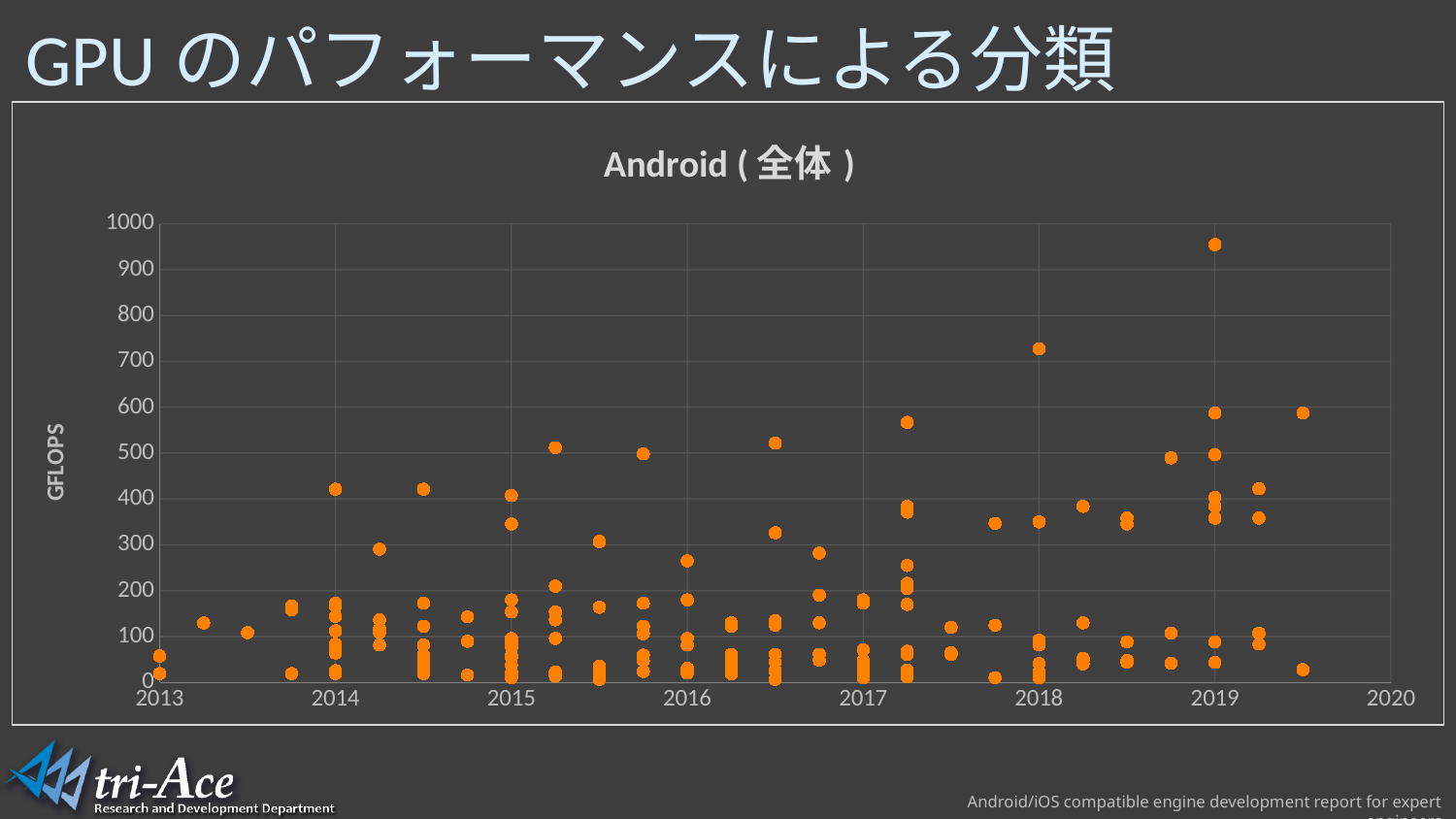
Is the highest point plotted near 2018 greater or less than 600 GFLOPS? greater Which is larger: the highest point plotted near 2019 or the highest point plotted near 2018? 2019 Is the highest point plotted between 2017 and 2018 greater or less than 500 GFLOPS? greater Is the highest point plotted at 2013 greater or less than 100 GFLOPS? less What kind of chart is shown on the slide? scatter chart What is the title of the chart? Android ( 全体 ) Does the maximum GFLOPS value generally rise or fall from 2013 to 2019? rise Around which year is the single highest GFLOPS point plotted? 2019 What is the label on the vertical axis of the chart? GFLOPS